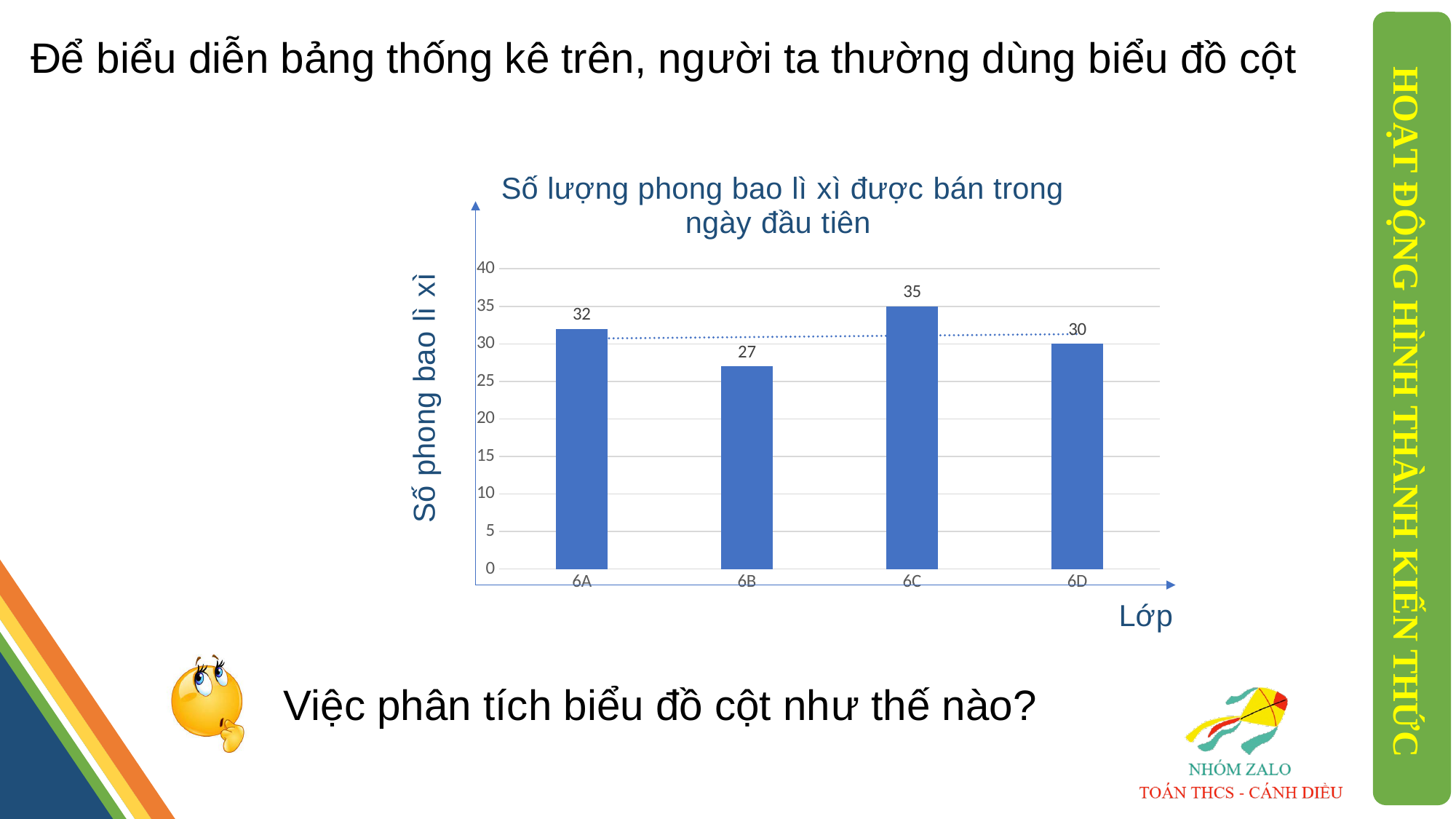
What is the value for class 6A? 32 Which class has the lowest value? 6B What is the value for class 6B? 27 Is the value for 6B greater or less than 30? less What kind of chart is shown on the slide? bar chart What is the difference between the values for 6C and 6B? 8 What is the title of the chart? Số lượng phong bao lì xì được bán trong ngày đầu tiên Which is larger, the value for 6A or the value for 6D? 6A How many classes are shown on the x axis? 4 What is the value for class 6D? 30 Which class has the highest value? 6C What is the value for class 6C? 35